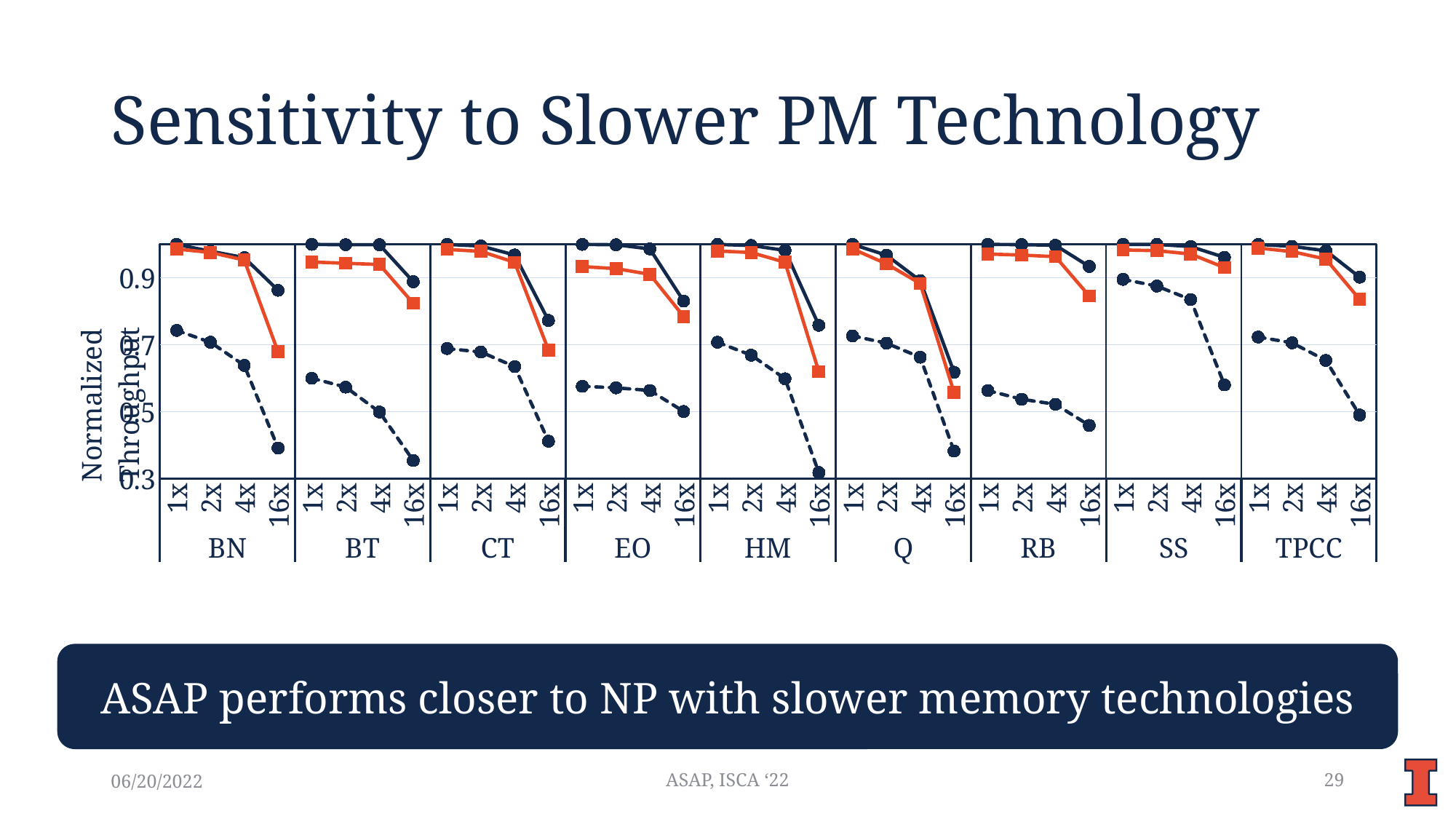
What kind of chart is shown on the slide? line chart In the HM panel, which is higher at 16x: the orange square line or the dashed line? the orange square line What are the x-axis tick labels in each panel? 1x, 2x, 4x, 16x How many x-axis points (slowdown factors) are plotted in each panel? 4 In the BN panel, is the dashed line's value at 16x greater or less than 0.5? less In the EO panel, is the dashed line's value at 1x greater or less than 0.5? greater In the BN panel, which is higher at 16x: the solid dark line or the dashed line? the solid dark line In the HM panel, is the dashed line's value at 16x greater or less than 0.5? less In the Q panel, does the dashed line rise or fall from 1x to 16x? fall How many benchmark panels (BN, BT, ...) does the chart contain? 9 What is the label of the y axis? Normalized Throughput